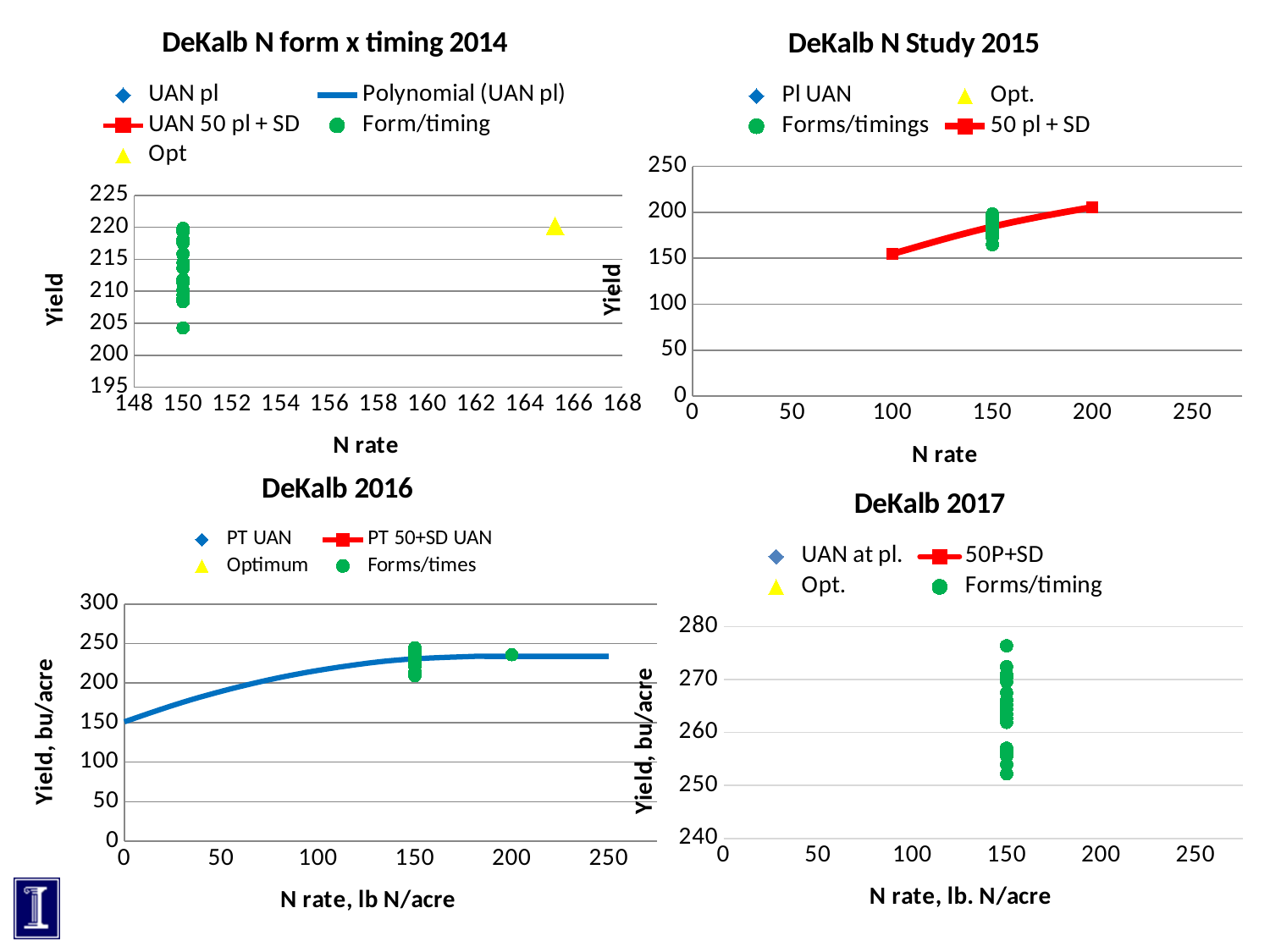
What is the y-axis label of the 'DeKalb 2016' chart? Yield, bu/acre How many charts are on the slide? 4 What kind of chart is the 'DeKalb 2017' chart? scatter chart In the 'DeKalb 2017' chart, is the highest 'Forms/timing' point greater or less than 270? greater In the 'DeKalb N Study 2015' chart, is the '50 pl + SD' yield at N rate 100 greater or less than 200? less In the 'DeKalb N Study 2015' chart, how many series does the legend list? 4 In the 'DeKalb N form x timing 2014' chart, how many series does the legend list? 5 In the 'DeKalb 2016' chart, is the yield of the blue curve at N rate 0 greater or less than 200? less In the 'DeKalb N Study 2015' chart, does the '50 pl + SD' line rise or fall as N rate increases from 100 to 200? rise In the 'DeKalb 2016' chart, how many series does the legend list? 4